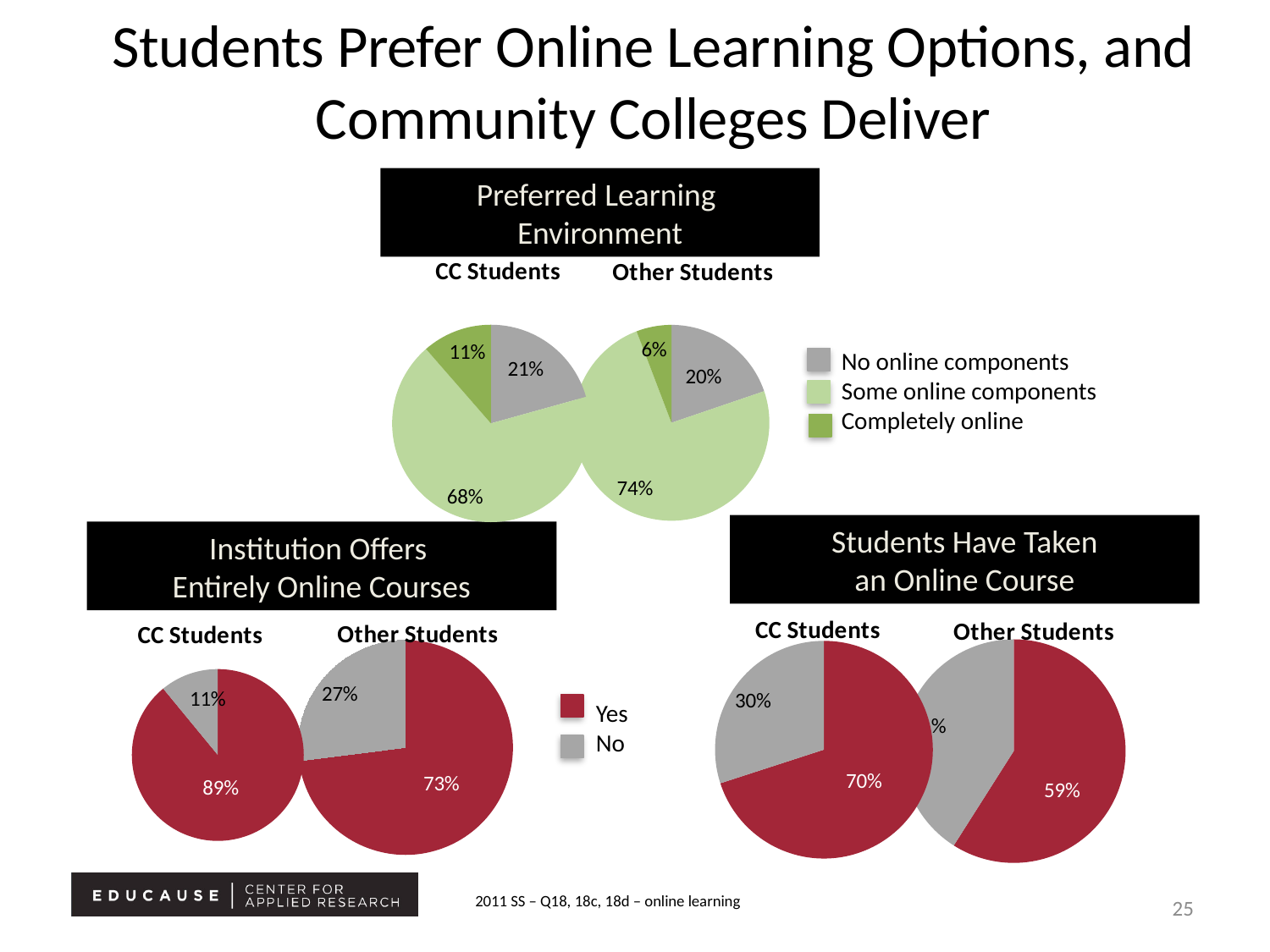
How many entries does the legend for the Preferred Learning Environment charts list? 3 In the Preferred Learning Environment chart for Other Students, what share of students prefer a completely online environment? 6% In the Institution Offers Entirely Online Courses chart for Other Students, what share answered No? 27% In the Preferred Learning Environment charts, how much larger is the 'Completely online' share for CC Students than for Other Students? 5% In the Institution Offers Entirely Online Courses chart for CC Students, what share answered Yes? 89% In the Students Have Taken an Online Course chart for Other Students, what share answered Yes? 59% In the Preferred Learning Environment chart for Other Students, which category has the largest share? Some online components In the Preferred Learning Environment chart for CC Students, what share of students prefer some online components? 68% In the Students Have Taken an Online Course chart for CC Students, what share answered Yes? 70% In the Preferred Learning Environment chart for CC Students, what share of students prefer no online components? 21% In the Preferred Learning Environment chart for CC Students, which category has the smallest share? Completely online In the Institution Offers Entirely Online Courses charts, which group has the larger Yes share, CC Students or Other Students? CC Students